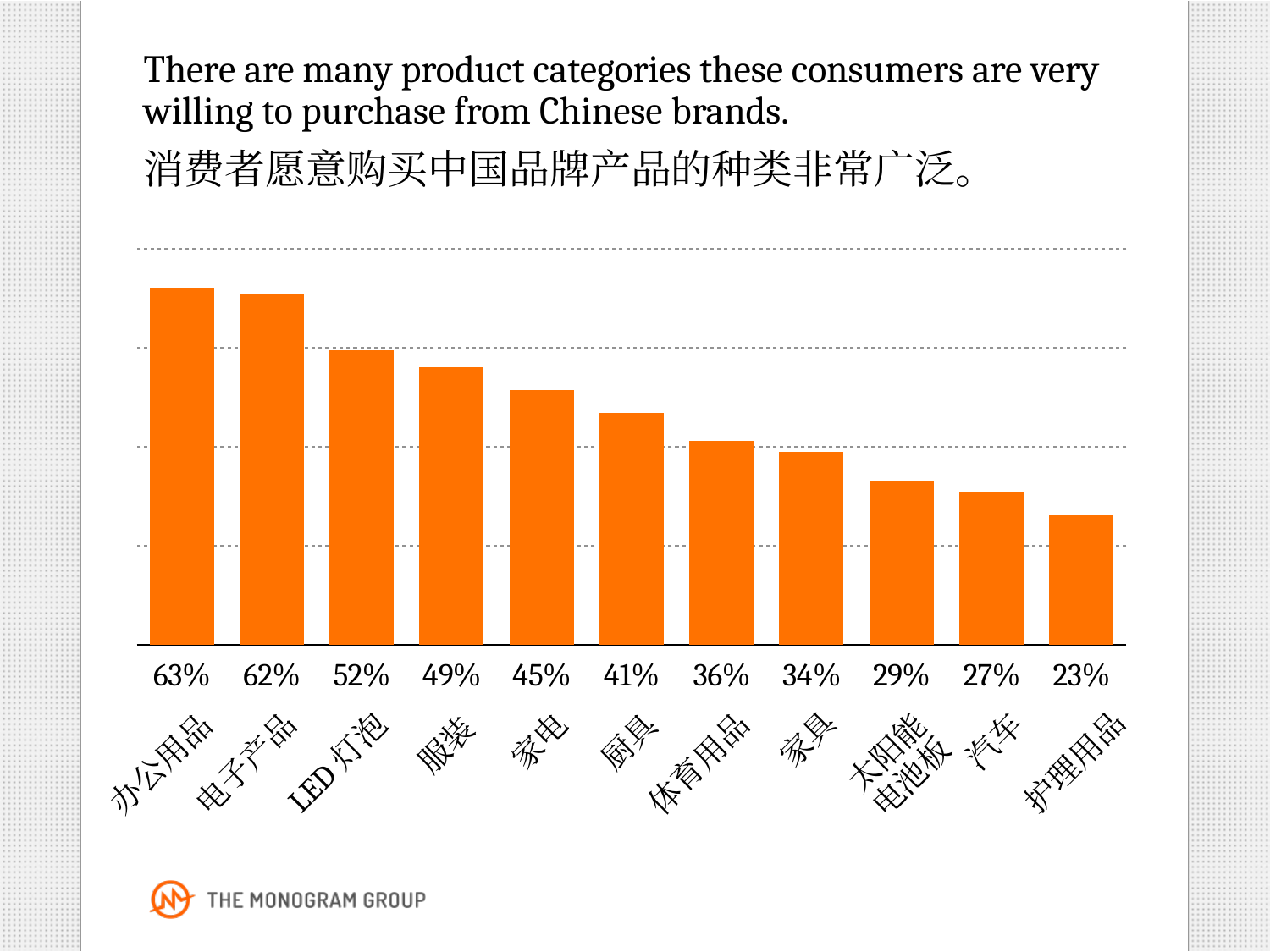
What colour are the bars in the chart? Orange What is the value for 办公用品? 63% What is the value for LED灯泡? 52% Do the values rise or fall from left to right along the x axis? Fall What kind of chart is shown on the slide? Bar chart Which category has the highest value? 办公用品 How many product categories are shown in the chart? 11 Which category has the lowest value? 护理用品 Which is larger, the value for 服装 or the value for 厨具? 服装 What is the value for 太阳能电池板? 29% What is the value for 家电? 45% What is the difference between the values for 电子产品 and 汽车? 35%